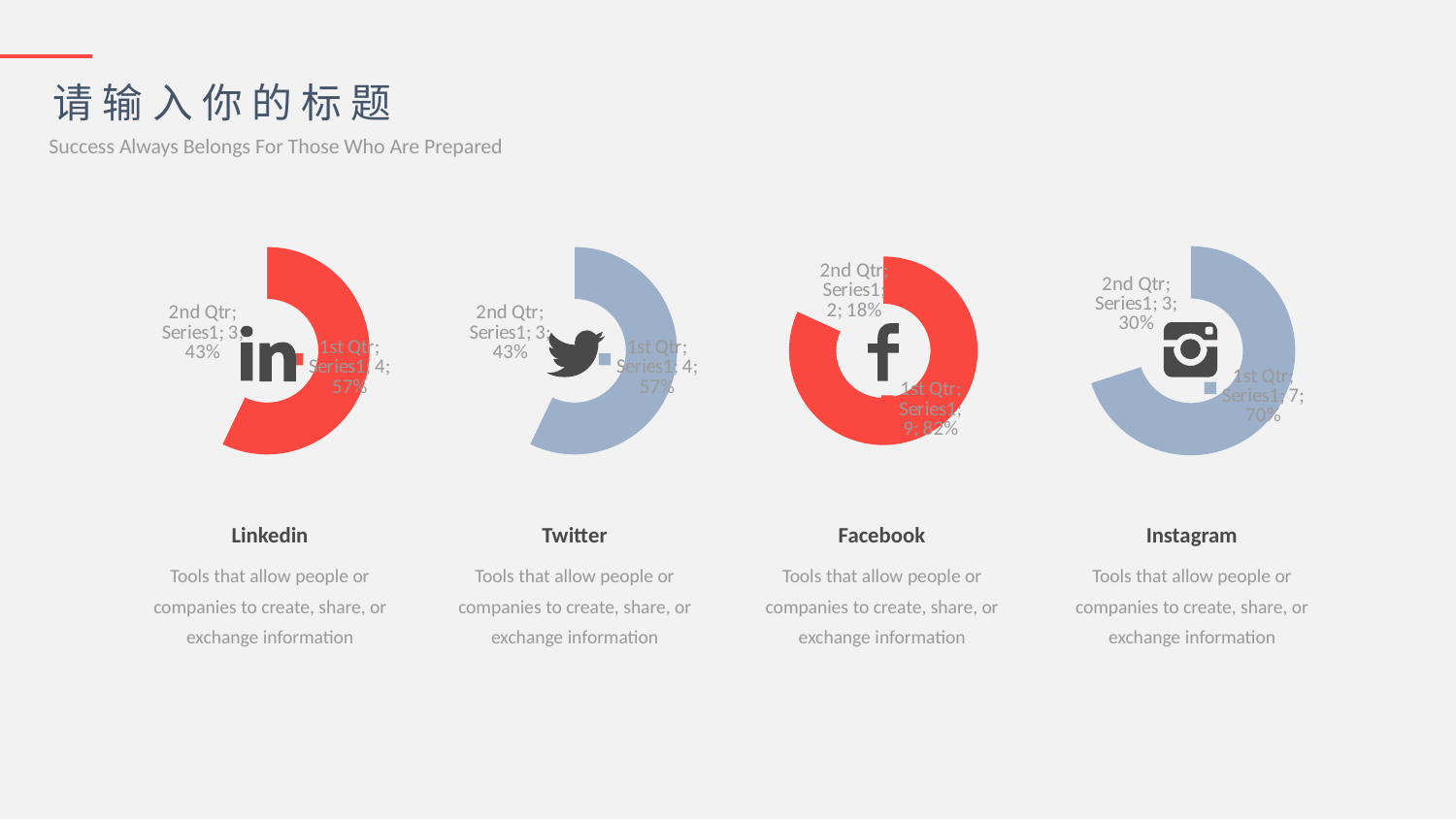
In the Linkedin chart, what percentage is shown for 2nd Qtr? 43% In the Instagram chart, what percentage is shown for 1st Qtr? 70% What type of chart is used for the Linkedin data? Doughnut chart In the Facebook chart, which quarter has the smaller share? 2nd Qtr In the Twitter chart, what percentage is shown for 1st Qtr? 57% In the Facebook chart, what value is shown for 1st Qtr? 9 In the Linkedin chart, what value is shown for 1st Qtr? 4 In the Facebook chart, what percentage is shown for 2nd Qtr? 18% How many slices does the Twitter chart have? 2 In the Facebook chart, what is the difference between the 1st Qtr value and the 2nd Qtr value? 7 In the Instagram chart, which quarter has the larger share? 1st Qtr In the Instagram chart, what is the total of the 1st Qtr and 2nd Qtr values? 10